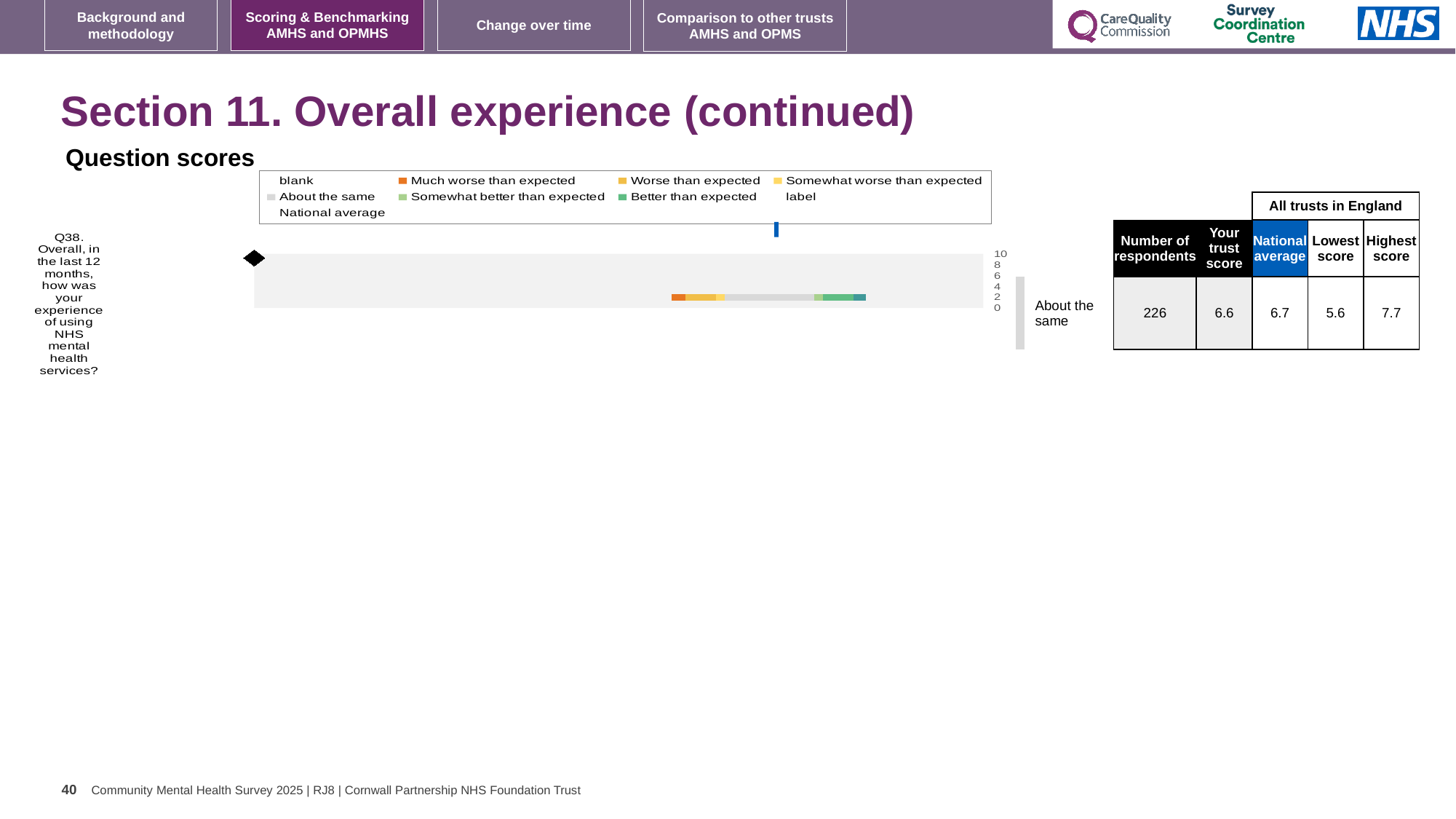
Which is larger for Q38, the trust score or the national average? National average How many survey questions are plotted in the chart? 1 What is the national average score for Q38? 6.7 What is the lowest score among all trusts in England for Q38? 5.6 What is the difference between the national average and the trust score for Q38? 0.1 What benchmark category label is shown for Q38 to the right of the chart? About the same What is the trust score for Q38 shown in the table next to the chart? 6.6 How many respondents answered Q38? 226 What is the difference between the highest score and the lowest score for Q38? 2.1 What is the highest score among all trusts in England for Q38? 7.7 Which colour in the legend represents 'Much worse than expected'? Orange What kind of chart is shown under 'Question scores'? bar chart